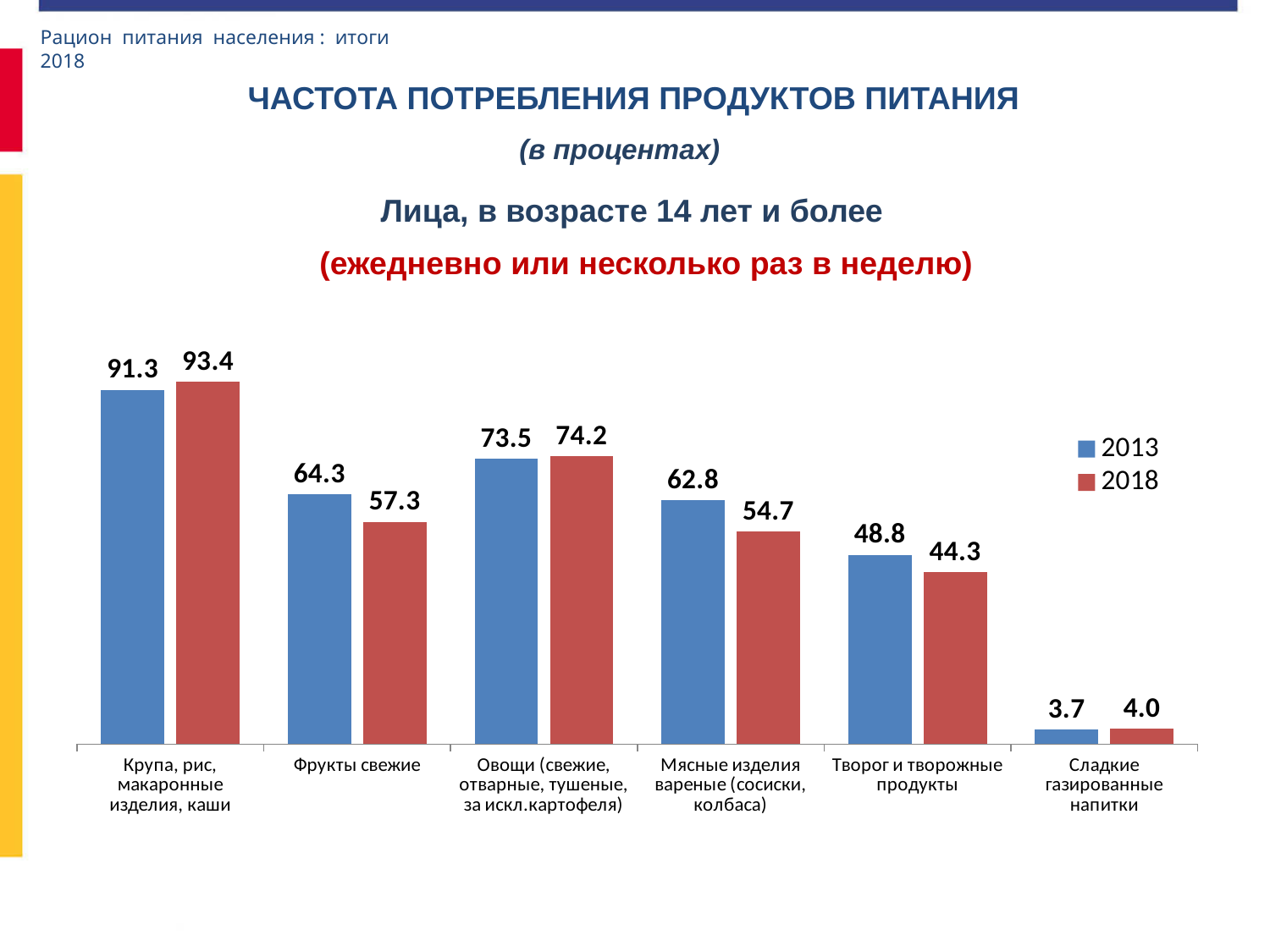
Which category has the highest 2018 value? Крупа, рис, макаронные изделия, каши What is the 2018 value for Сладкие газированные напитки? 4.0 Which colour represents the 2013 series in the legend? Blue Which is larger for Овощи (свежие, отварные, тушеные, за искл.картофеля): the 2013 value or the 2018 value? 2018 What is the difference between the 2018 and 2013 values for Крупа, рис, макаронные изделия, каши? 2.1 Which category has the lowest 2013 value? Сладкие газированные напитки What is the difference between the 2013 and 2018 values for Мясные изделия вареные (сосиски, колбаса)? 8.1 How many product categories are shown on the chart? 6 What is the 2018 value for Фрукты свежие? 57.3 What is the 2013 value for Творог и творожные продукты? 48.8 How many series does the legend list? 2 What kind of chart is shown on the slide? Bar chart